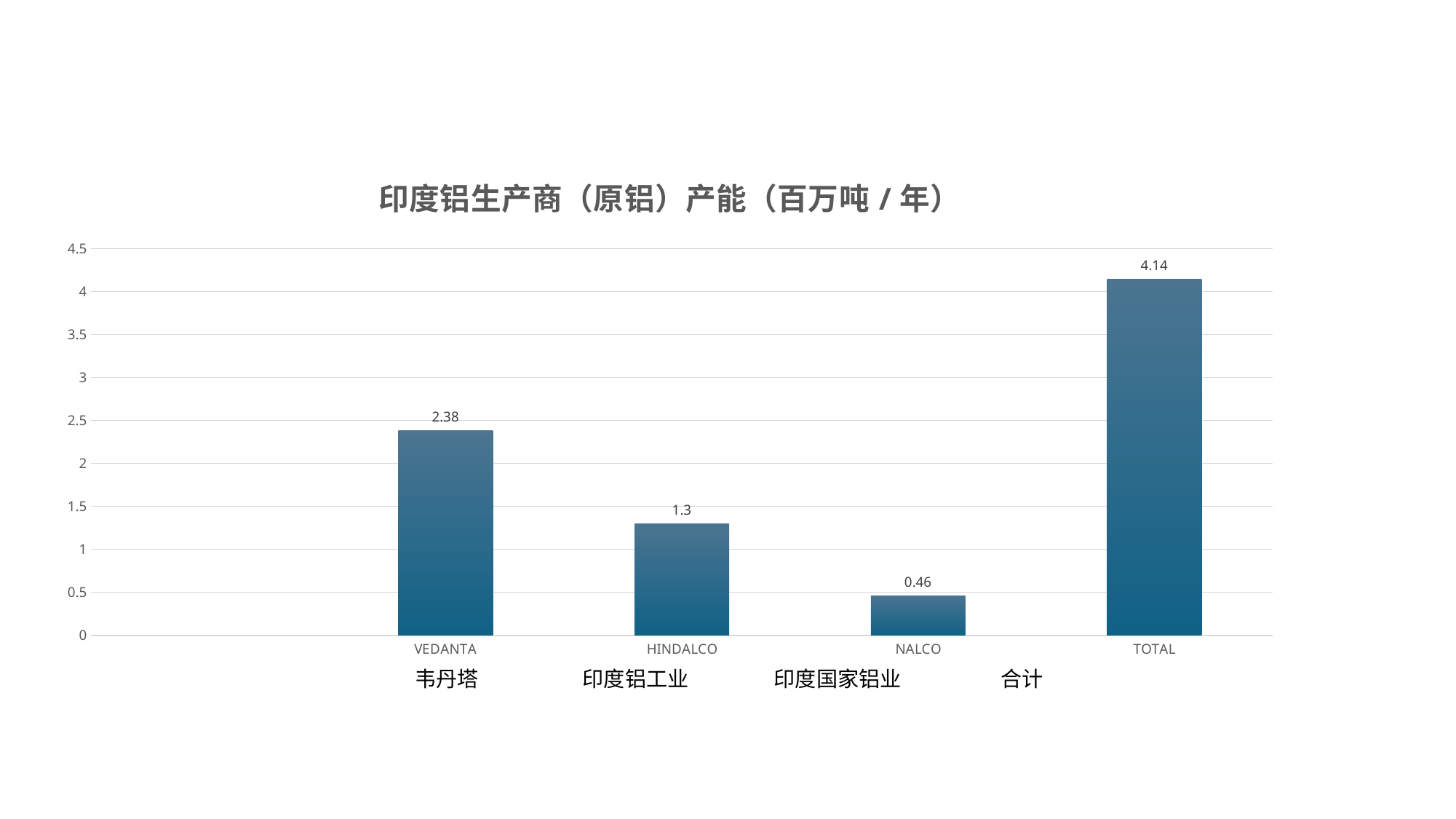
What is the value for HINDALCO? 1.3 What is the value for TOTAL? 4.14 What kind of chart is shown on the slide? bar chart Which category has the highest value? TOTAL What is the title of the chart? 印度铝生产商（原铝）产能（百万吨 / 年） What is the value for VEDANTA? 2.38 Which category has the lowest value? NALCO Which is larger, the value for HINDALCO or the value for NALCO? HINDALCO What is the value for NALCO? 0.46 What is the difference between the values for VEDANTA and HINDALCO? 1.08 How many bars are shown in the chart? 4 Is the value for VEDANTA greater or less than 2? greater